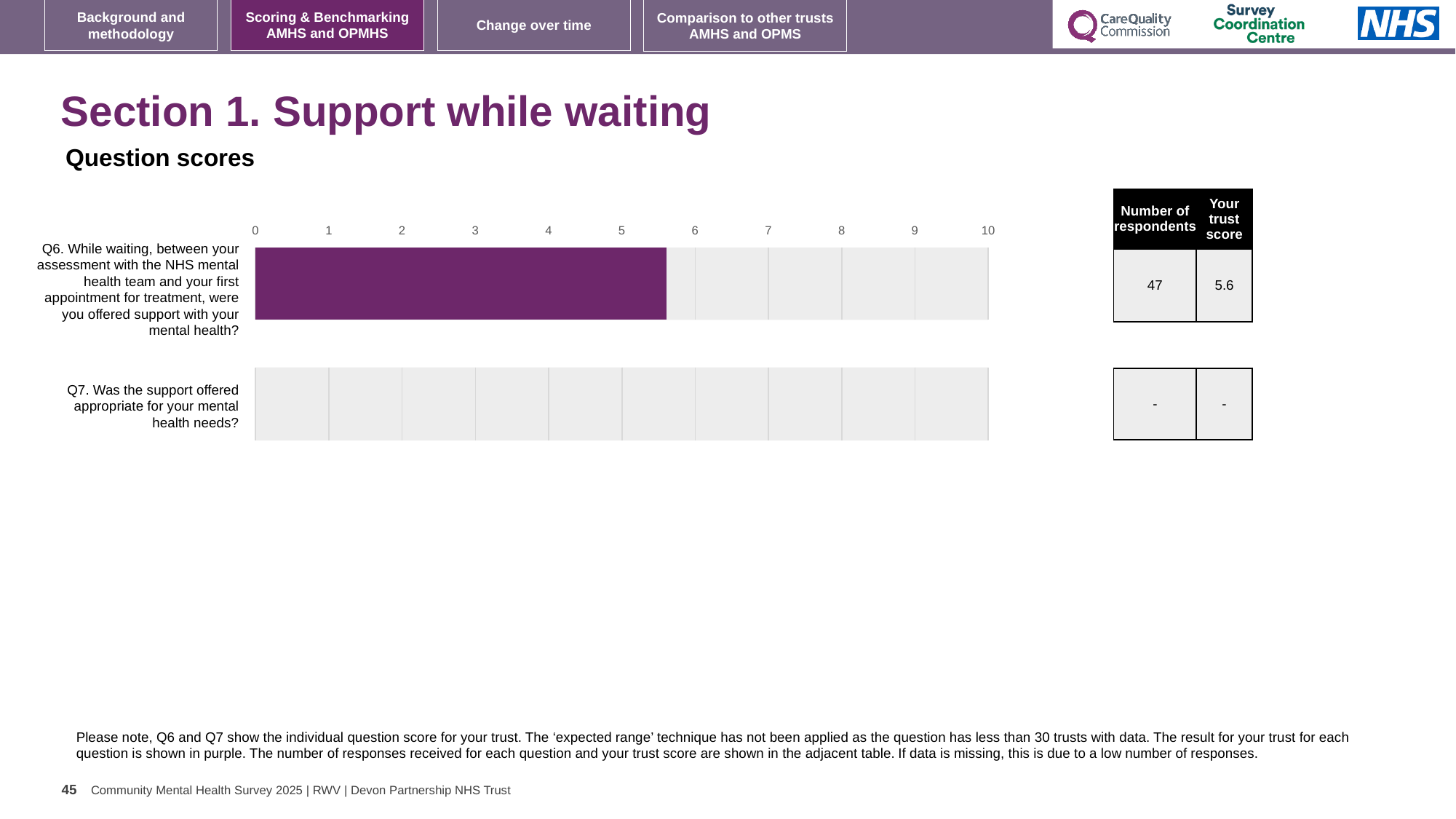
Which question on the chart has no bar plotted and shows '-' in the table? Q7 What is the trust score for Q6 shown in the table next to the chart? 5.6 Is the value of the bar for Q6 greater or less than 5? greater What kind of chart is shown on the slide? bar chart What colour is the bar for Q6? purple Is the value of the bar for Q6 greater or less than 6? less What is the maximum value shown on the chart's axis? 10 How many questions are listed as categories on the chart? 2 How many respondents answered Q6 according to the table beside the chart? 47